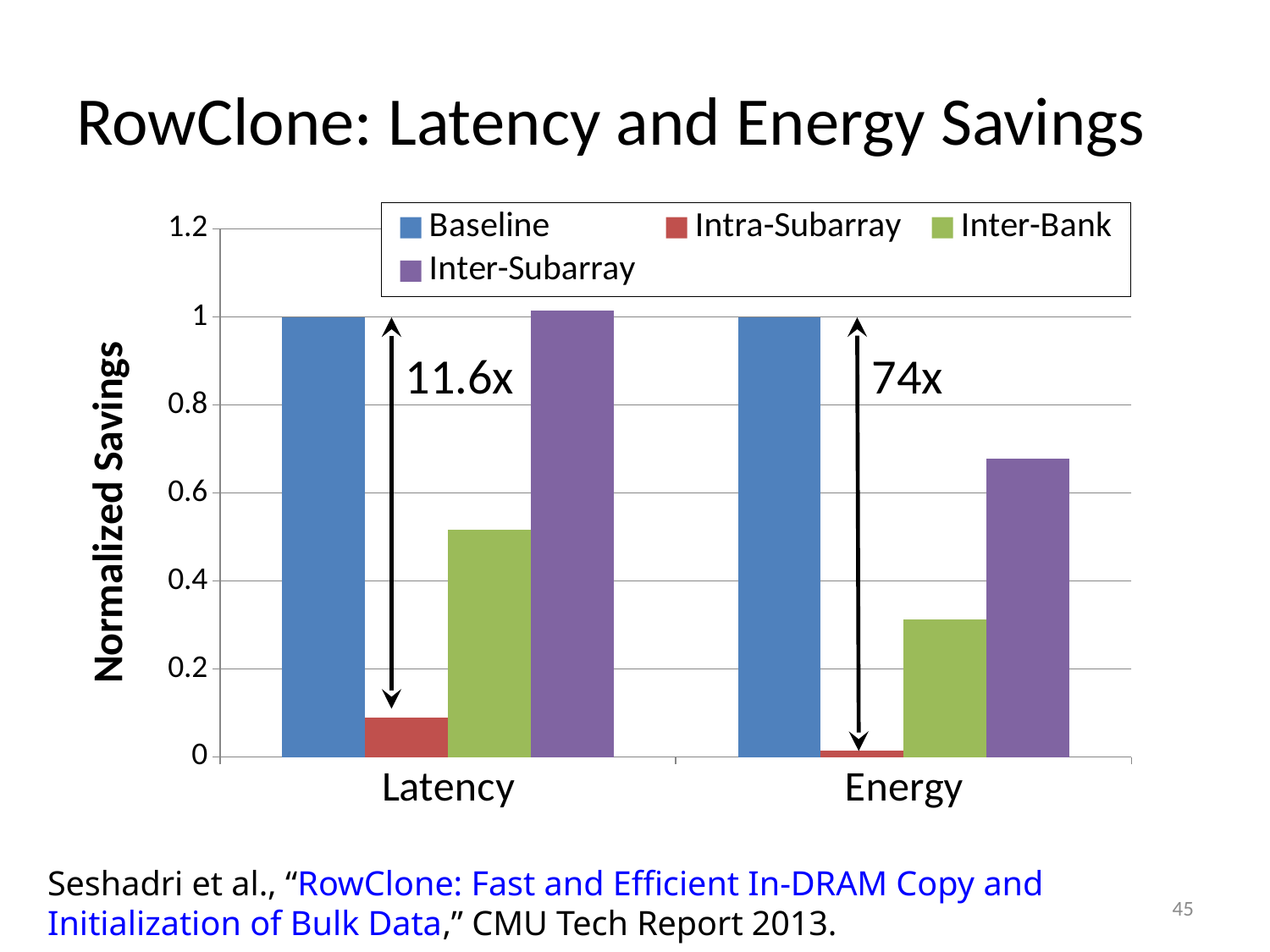
What is the Baseline value for Energy? 1 What kind of chart is shown on the slide? bar chart Is the Inter-Bank value for Energy greater or less than 0.4? less Is the Inter-Subarray value for Energy greater or less than 0.6? greater Is the Inter-Bank value for Latency greater or less than 0.4? greater Which is larger: the Inter-Bank value for Latency or the Inter-Bank value for Energy? Latency What is the title of the y axis? Normalized Savings Which series has the highest value for Energy? Baseline How many series does the legend list? 4 Which series has the lowest value for Latency? Intra-Subarray What improvement factor is annotated above the Intra-Subarray bar for Energy? 74x How many categories are shown on the x axis? 2